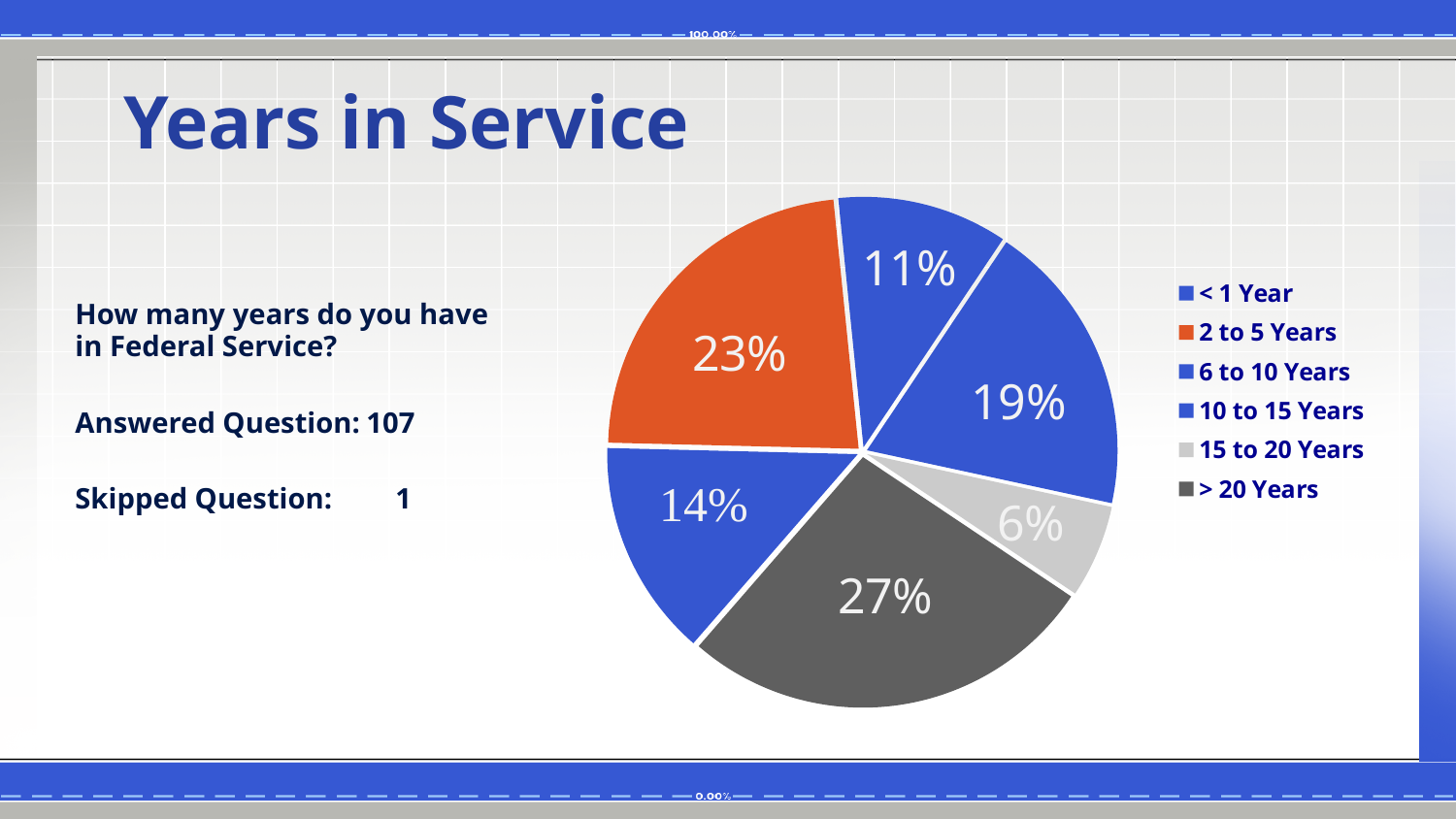
What share of the pie does the "> 20 Years" slice represent? 27% Which category has the largest slice of the pie? > 20 Years What share of the pie does the "15 to 20 Years" slice represent? 6% How many categories does the legend list? 6 What is the difference in percentage points between the "> 20 Years" slice and the "2 to 5 Years" slice? 4 Which category has the smallest slice of the pie? 15 to 20 Years What is the difference in percentage points between the "2 to 5 Years" slice and the "15 to 20 Years" slice? 17 What share of the pie does the "2 to 5 Years" slice represent? 23% What kind of chart is shown on the slide? pie chart Which slice is larger, "2 to 5 Years" or "15 to 20 Years"? 2 to 5 Years What colour is the "2 to 5 Years" slice in the pie chart? orange What is the title of the slide containing the pie chart? Years in Service